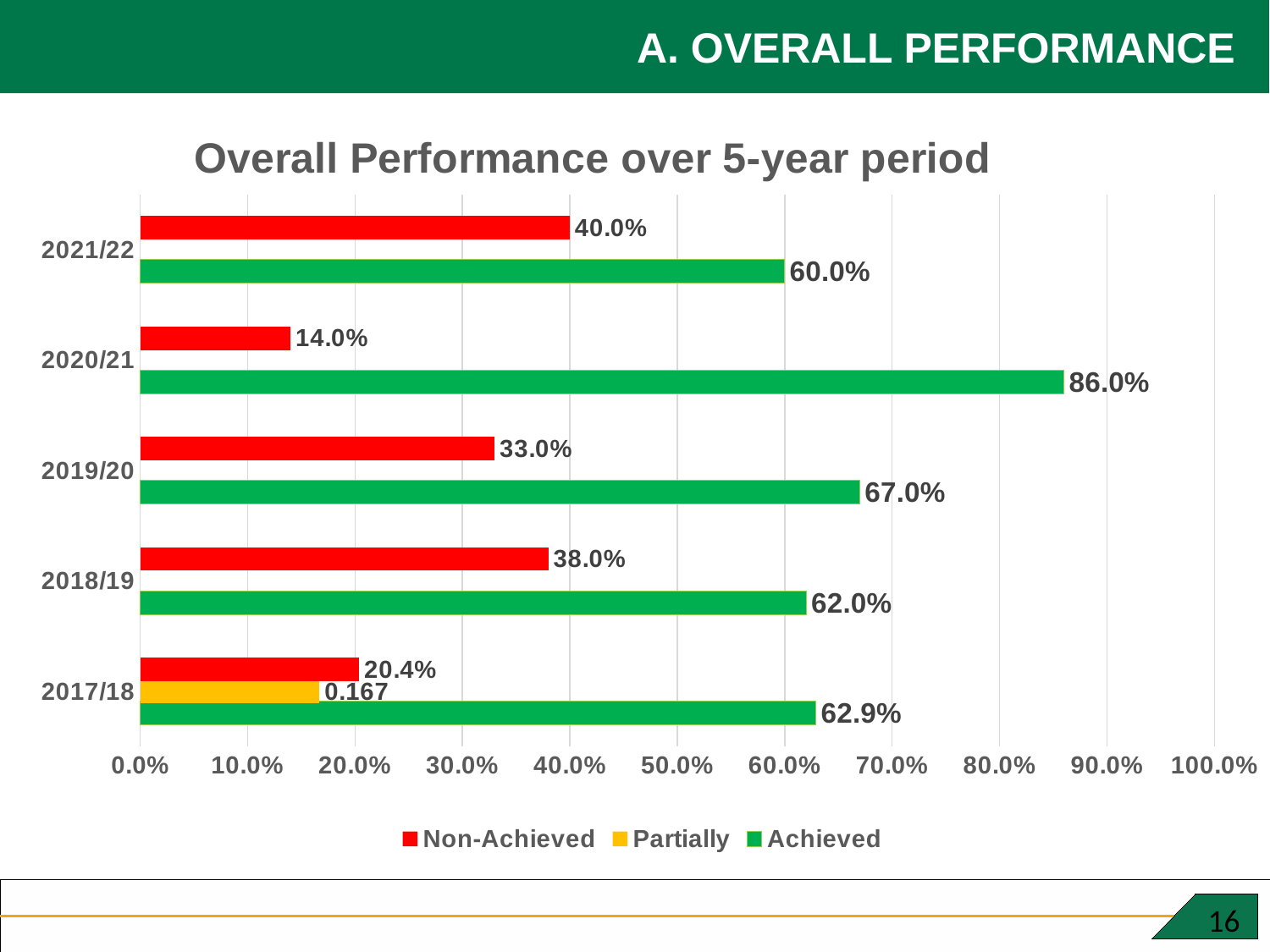
Which is larger, the Non-Achieved value for 2018/19 or for 2019/20? 2018/19 What is the difference between the Achieved values for 2020/21 and 2019/20? 19.0% What is the Non-Achieved value for 2021/22? 40.0% How many years are shown on the chart? 5 What is the Partially value for 2017/18? 0.167 What is the title of the chart? Overall Performance over 5-year period Which year has the highest Achieved value? 2020/21 Which year has the lowest Non-Achieved value? 2020/21 How many series does the legend list? 3 What is the Achieved value for 2020/21? 86.0% Is the Achieved value for 2017/18 greater or less than 60.0%? greater What kind of chart is shown on the slide? bar chart